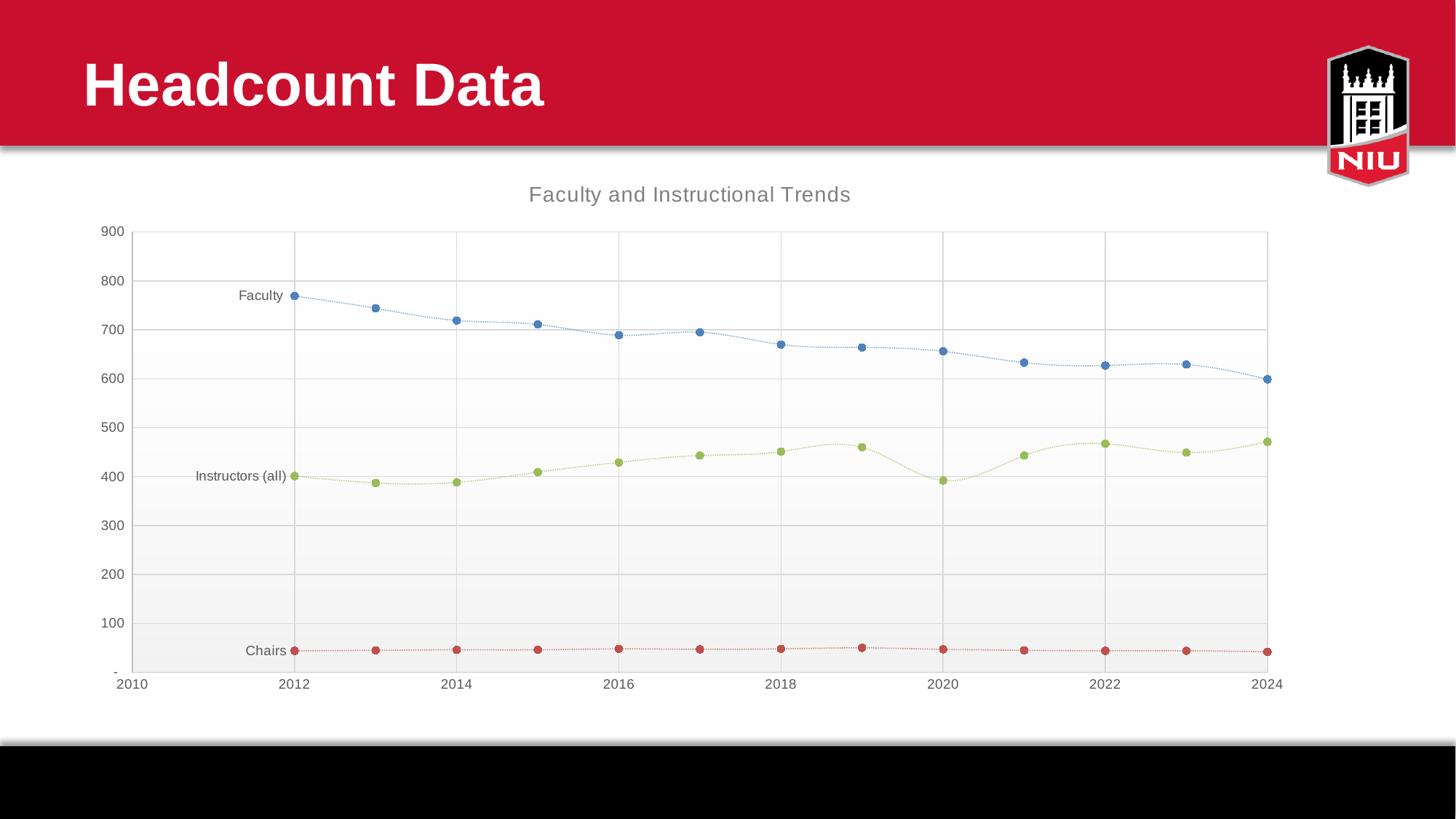
How many series are plotted in the chart? 3 How many data points does the Faculty series have? 13 Which series has the larger value in 2024, Faculty or Instructors (all)? Faculty What is the title of the chart? Faculty and Instructional Trends In which year is the Faculty value highest? 2012 Is the Chairs value for 2018 greater or less than 100? less Is the Faculty value for 2012 greater or less than 700? greater What kind of chart is shown on the slide? line chart Which series is plotted in red? Chairs In which year is the Faculty value lowest? 2024 Does the Faculty series rise or fall from 2012 to 2024? fall